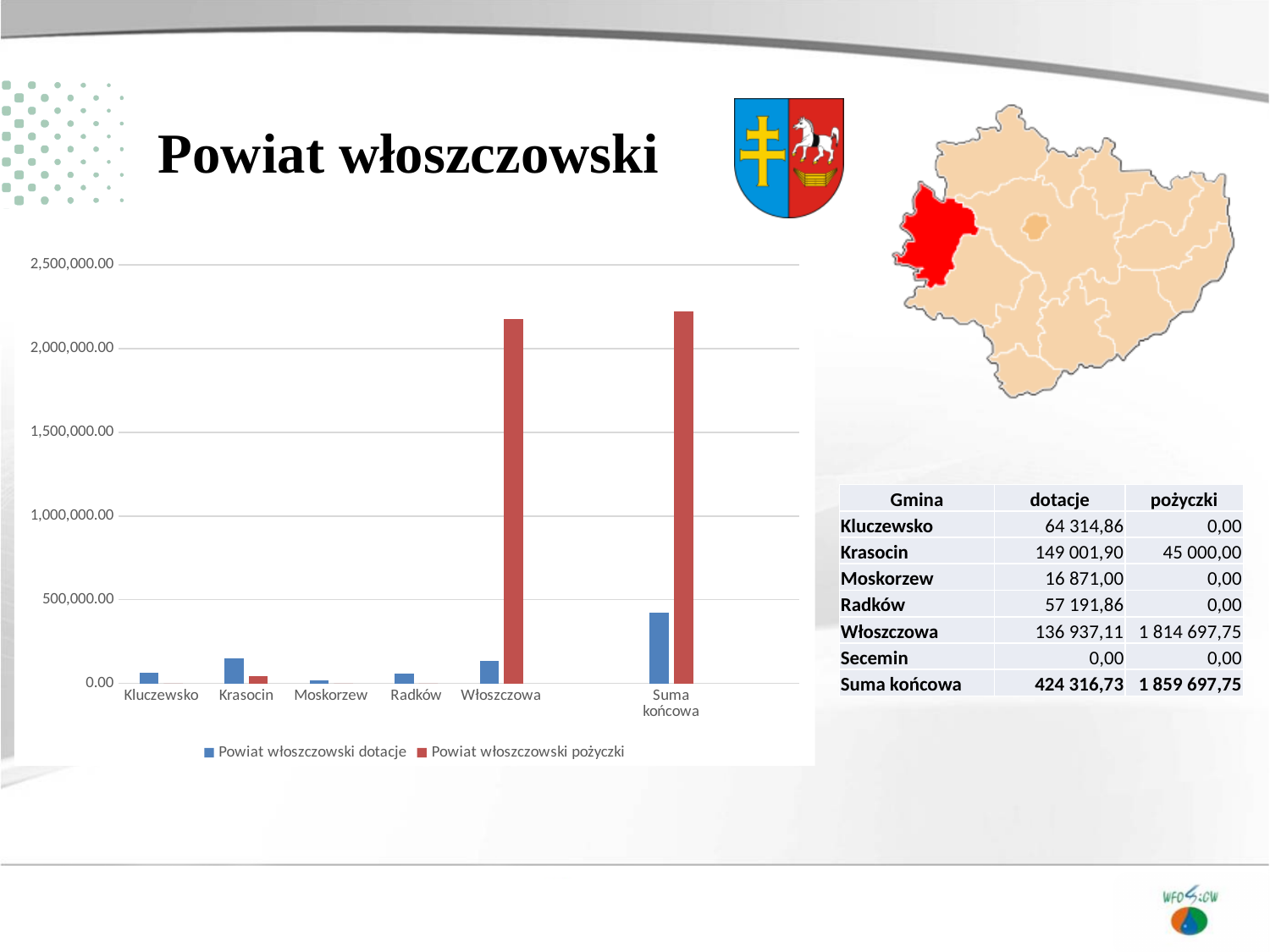
Is the pożyczki value for Włoszczowa greater or less than 1,500,000.00? greater What type of chart is shown on the slide? bar chart Which colour represents the 'Powiat włoszczowski pożyczki' series in the chart? red What are the two series named in the chart legend? Powiat włoszczowski dotacje and Powiat włoszczowski pożyczki How many series does the chart legend list? 2 According to the table on the slide, what is the dotacje value for Radków? 57 191,86 Is the dotacje value for Suma końcowa greater or less than 500,000.00? less Which gmina has the lowest dotacje bar among the labelled gminas in the chart? Moskorzew Which gmina (excluding Suma końcowa) has the highest pożyczki bar in the chart? Włoszczowa According to the table on the slide, what is the pożyczki value for Krasocin? 45 000,00 How many category labels are shown on the x axis of the chart? 6 Which is larger, the dotacje value for Suma końcowa or the dotacje value for Włoszczowa? Suma końcowa